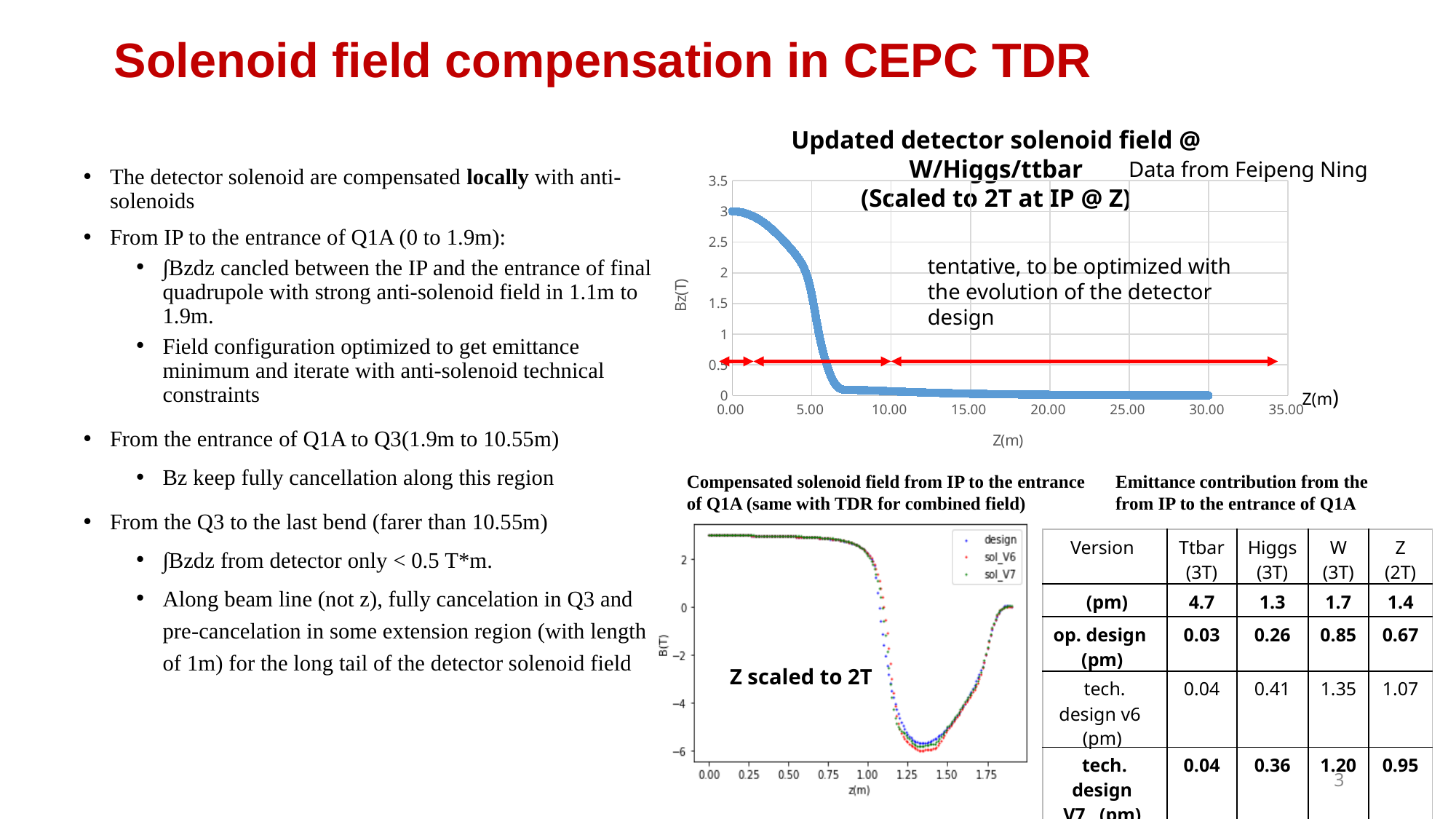
In the bottom chart 'Compensated solenoid field from IP to the entrance of Q1A', is the value of B(T) at z = 0.00 m greater or less than 2? greater What kind of chart is the bottom chart 'Compensated solenoid field from IP to the entrance of Q1A'? scatter chart In the bottom chart 'Compensated solenoid field from IP to the entrance of Q1A', what are the names of the series in the legend? design, sol_V6, sol_V7 In the top chart 'Updated detector solenoid field @ W/Higgs/ttbar', is the value of Bz at Z = 10.00 m greater or less than 0.5? less In the top chart 'Updated detector solenoid field @ W/Higgs/ttbar', does Bz rise or fall as Z increases from 0 to 10 m? fall In the bottom chart 'Compensated solenoid field from IP to the entrance of Q1A', does B(T) rise or fall as z increases from 1.00 m to 1.25 m? fall In the bottom chart 'Compensated solenoid field from IP to the entrance of Q1A', is the value of B(T) at z = 1.00 m greater or less than 2? greater In the top chart 'Updated detector solenoid field @ W/Higgs/ttbar', what is the largest tick value shown on the x axis? 35.00 In the top chart 'Updated detector solenoid field @ W/Higgs/ttbar', what is the label of the y axis? Bz(T) In the bottom chart 'Compensated solenoid field from IP to the entrance of Q1A', how many series does the legend list? 3